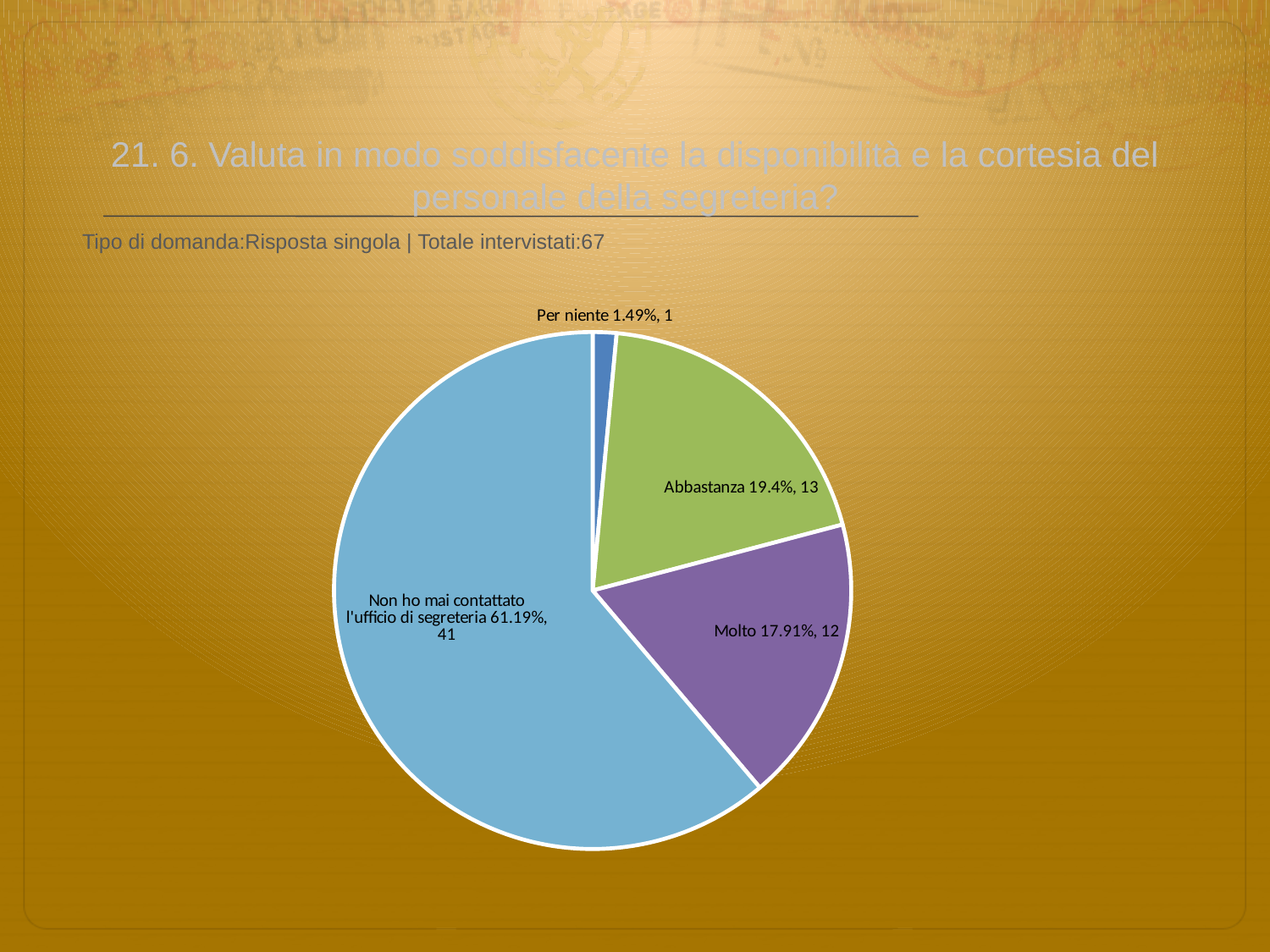
How many respondents chose 'Abbastanza'? 13 Which has more respondents, 'Non ho mai contattato l'ufficio di segreteria' or 'Abbastanza'? Non ho mai contattato l'ufficio di segreteria What is the total number of respondents stated on the slide (Totale intervistati)? 67 What is the difference in respondent count between 'Abbastanza' and 'Molto'? 1 Which category has the largest slice? Non ho mai contattato l'ufficio di segreteria What percentage share does the 'Non ho mai contattato l'ufficio di segreteria' slice have? 61.19% How many slices does the pie chart have? 4 Which category has the smallest slice? Per niente What colour is the 'Molto' slice? purple What kind of chart is shown on the slide? pie chart What percentage share does the 'Per niente' slice have? 1.49% How many respondents chose 'Molto'? 12